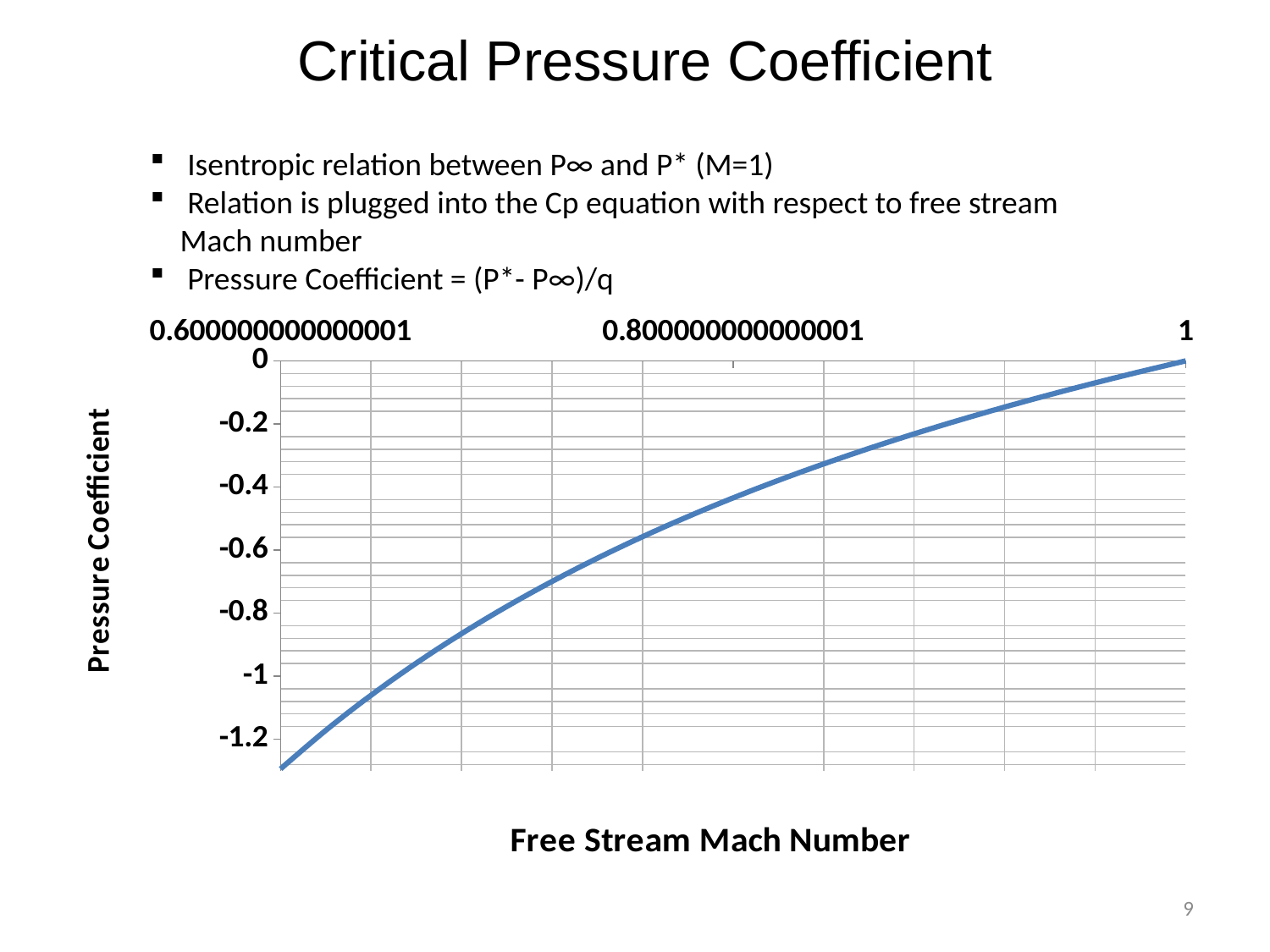
Is the pressure coefficient at a free stream Mach number of 0.9 greater or less than -0.6? greater Which has the larger pressure coefficient: a free stream Mach number of 0.8 or 0.6? 0.8 Is the pressure coefficient at a free stream Mach number of 0.6 greater or less than -1.2? less What is the pressure coefficient at a free stream Mach number of 1? 0 Is the pressure coefficient at a free stream Mach number of 0.8 greater or less than -0.8? greater What kind of chart is shown on the slide? line chart What is the title of the x axis of the chart? Free Stream Mach Number At which free stream Mach number shown on the x axis is the pressure coefficient lowest? 0.600000000000001 Does the pressure coefficient rise or fall as the free stream Mach number increases from 0.6 to 1? rise What is the title of the y axis of the chart? Pressure Coefficient At which free stream Mach number shown on the x axis is the pressure coefficient highest? 1